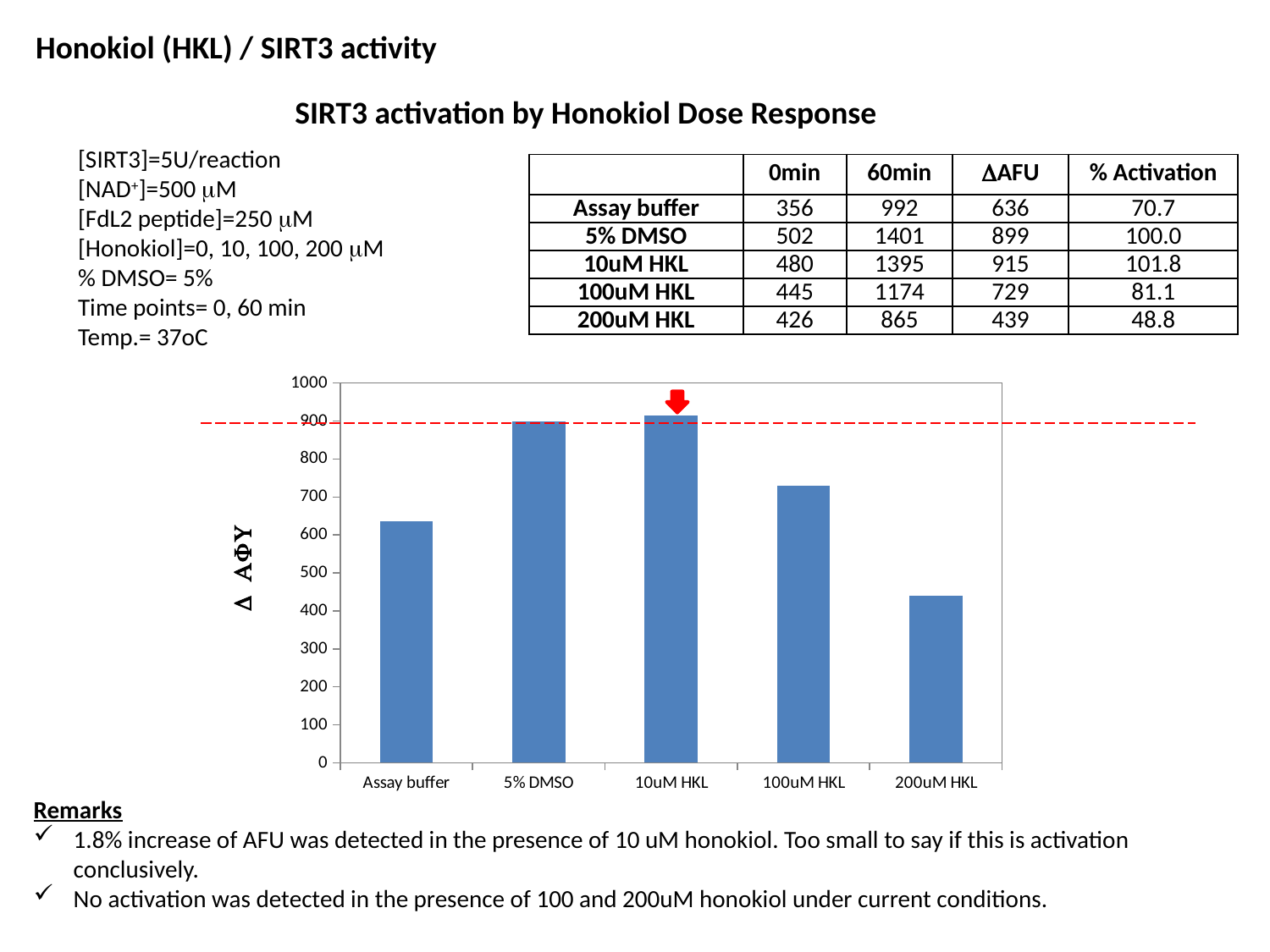
Which bar is taller, Assay buffer or 100uM HKL? 100uM HKL What kind of chart is shown on the slide? bar chart How many categories are plotted on the x axis of the chart? 5 Which category has the lowest bar in the chart? 200uM HKL Is the value for Assay buffer greater or less than 600? greater Which bar is taller, 5% DMSO or 200uM HKL? 5% DMSO Using the ΔAFU values in the table, what is the difference between 100uM HKL and 200uM HKL? 290 According to the table, what is the ΔAFU value for 100uM HKL? 729 Do the bar values rise or fall from 10uM HKL to 200uM HKL? fall According to the table, what is the ΔAFU value for 200uM HKL? 439 Is the value for 200uM HKL greater or less than 500? less Is the value for 100uM HKL greater or less than 700? greater